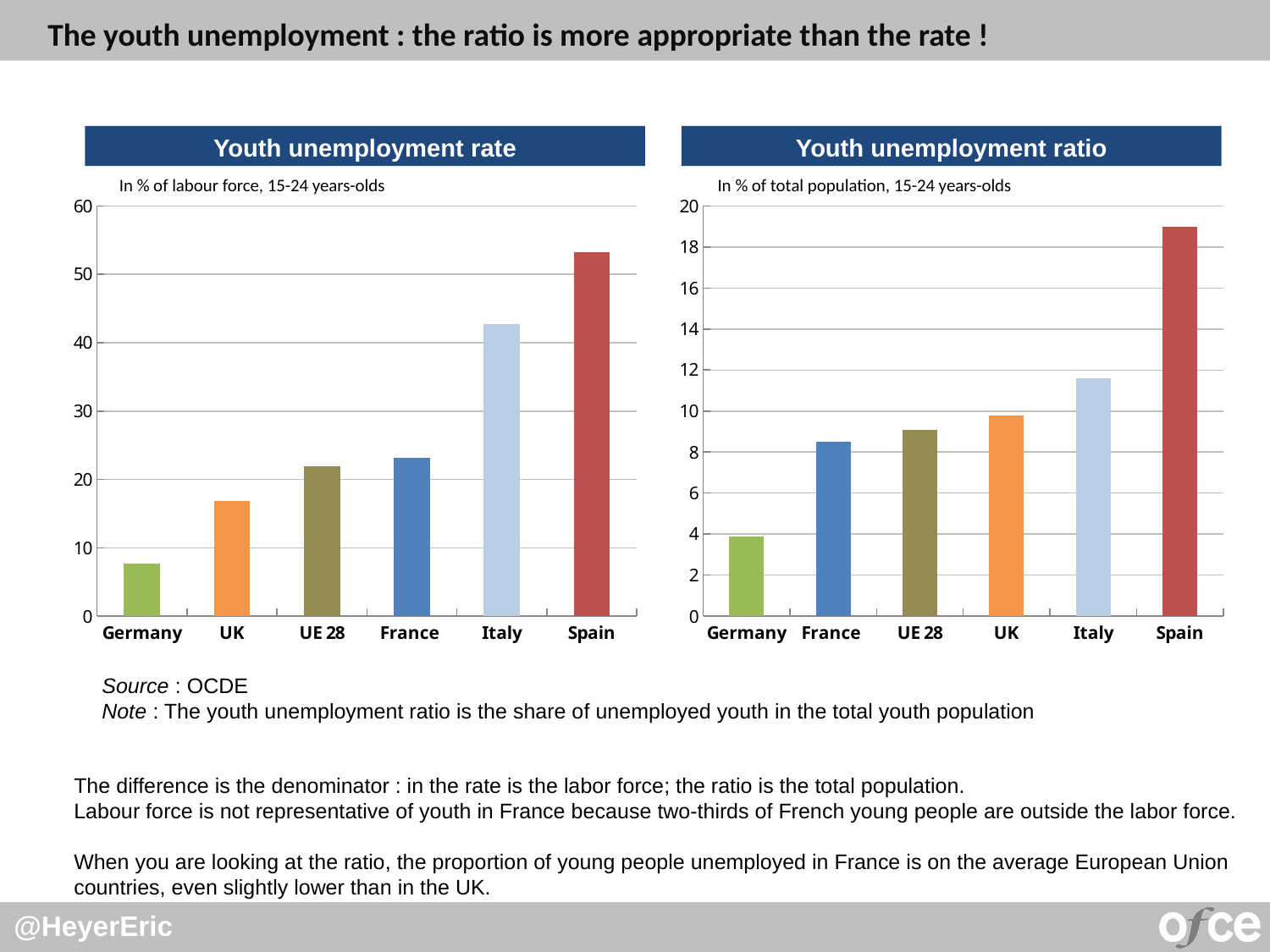
In the 'Youth unemployment rate' chart, is the value for Germany greater or less than 10? less In the 'Youth unemployment rate' chart, which is larger, the value for UK or the value for Italy? Italy In the 'Youth unemployment ratio' chart, is the value for Spain greater or less than 18? greater In the 'Youth unemployment ratio' chart, which country has the lowest value? Germany In the 'Youth unemployment rate' chart, is the value for Spain greater or less than 50? greater What type of chart is the 'Youth unemployment ratio' chart? Bar chart In the 'Youth unemployment rate' chart, which country has the highest value? Spain In the 'Youth unemployment ratio' chart, which country has the highest value? Spain In the 'Youth unemployment rate' chart, which country has the lowest value? Germany How many countries or groups are shown in the 'Youth unemployment rate' chart? 6